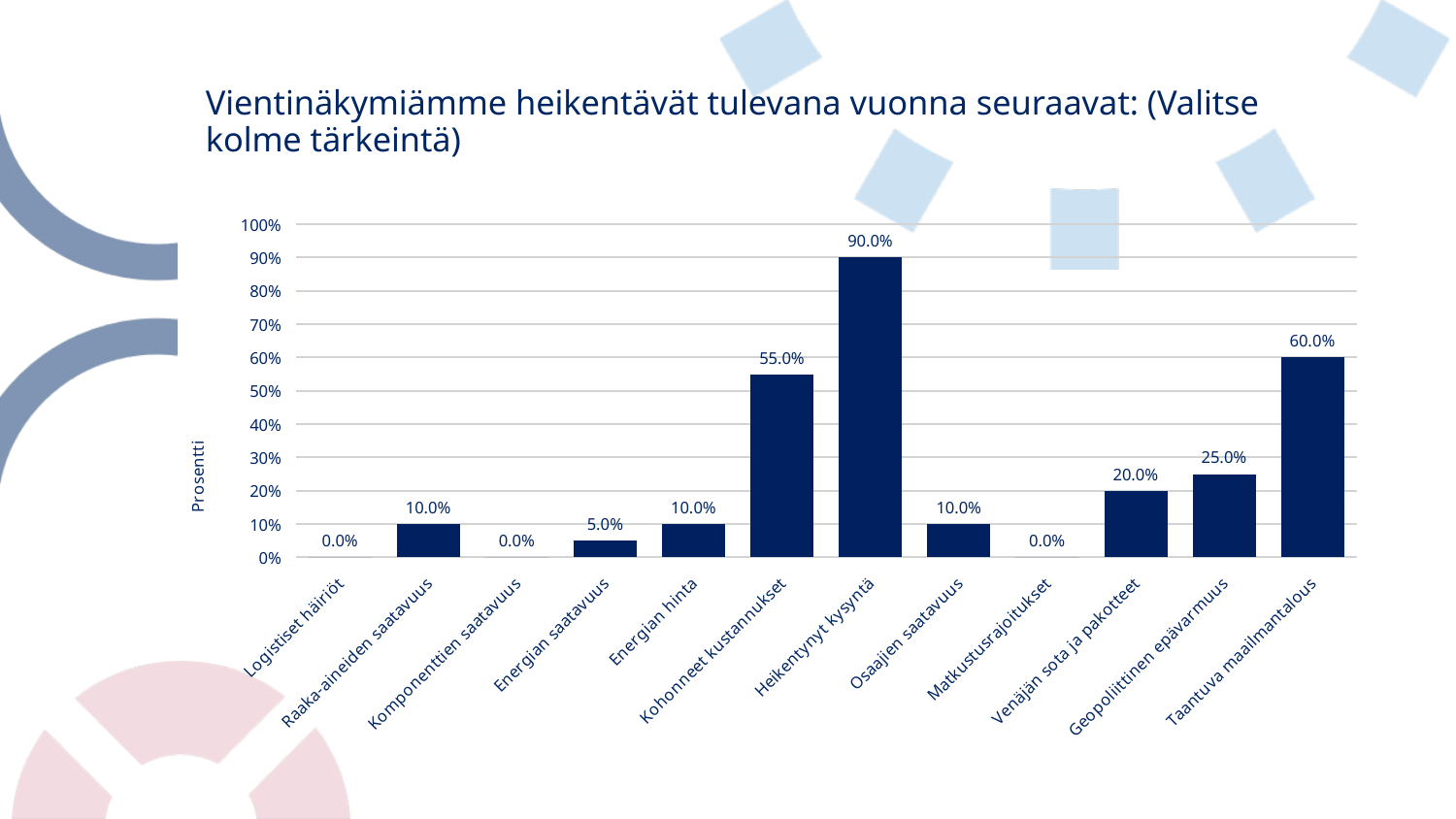
What is the label of the y axis? Prosentti What kind of chart is shown on the slide? Bar chart What is the value for Kohonneet kustannukset? 55.0% What is the value for Heikentynyt kysyntä? 90.0% What is the difference between Geopoliittinen epävarmuus and Venäjän sota ja pakotteet? 5.0% How many categories are shown on the x axis? 12 What is the value for Energian saatavuus? 5.0% What is the difference between Heikentynyt kysyntä and Taantuva maailmantalous? 30.0% What is the value for Taantuva maailmantalous? 60.0% Which category has the highest value? Heikentynyt kysyntä Which is larger, Kohonneet kustannukset or Taantuva maailmantalous? Taantuva maailmantalous What is the value for Geopoliittinen epävarmuus? 25.0%